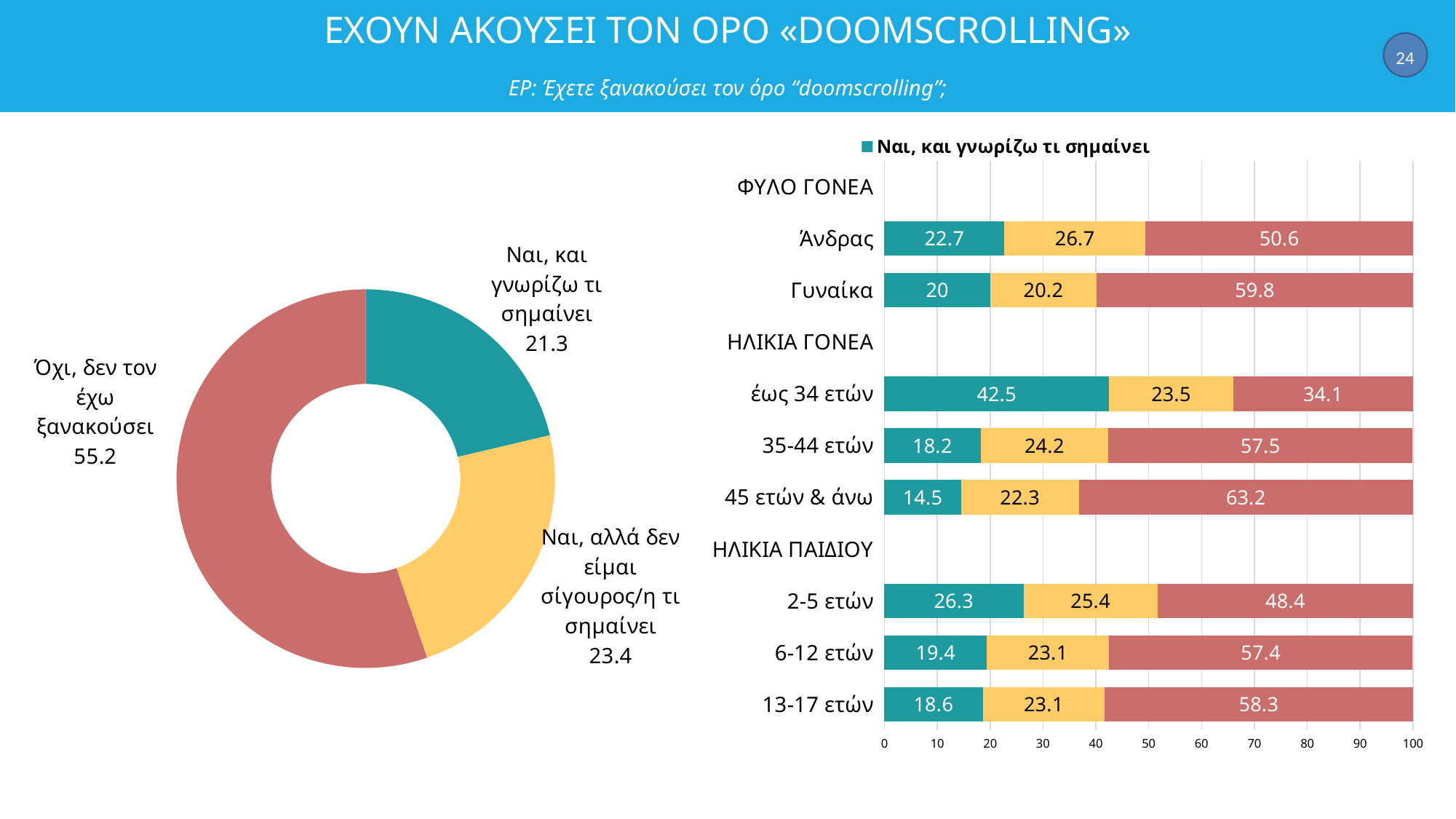
In the bar chart on the right, what is the teal ("Ναι, και γνωρίζω τι σημαίνει") value for "έως 34 ετών"? 42.5 In the bar chart on the right, what is the red (rightmost) segment value for "Γυναίκα"? 59.8 In the donut chart on the left, how many slices are there? 3 In the donut chart on the left, what is the value for "Όχι, δεν τον έχω ξανακούσει"? 55.2 In the bar chart on the right, which has a larger red (rightmost) segment value: "35-44 ετών" or "45 ετών & άνω"? 45 ετών & άνω In the bar chart on the right, what is the difference between the teal values for "Άνδρας" and "Γυναίκα"? 2.7 In the bar chart on the right, what is the yellow (middle) segment value for "2-5 ετών"? 25.4 What kind of chart is on the left side of the slide? Donut (pie) chart In the bar chart on the right, which category has the lowest teal ("Ναι, και γνωρίζω τι σημαίνει") value? 45 ετών & άνω In the bar chart on the right, which category has the highest teal ("Ναι, και γνωρίζω τι σημαίνει") value? έως 34 ετών In the donut chart on the left, which category has the smallest share? Ναι, και γνωρίζω τι σημαίνει What kind of chart is on the right side of the slide? Stacked bar chart